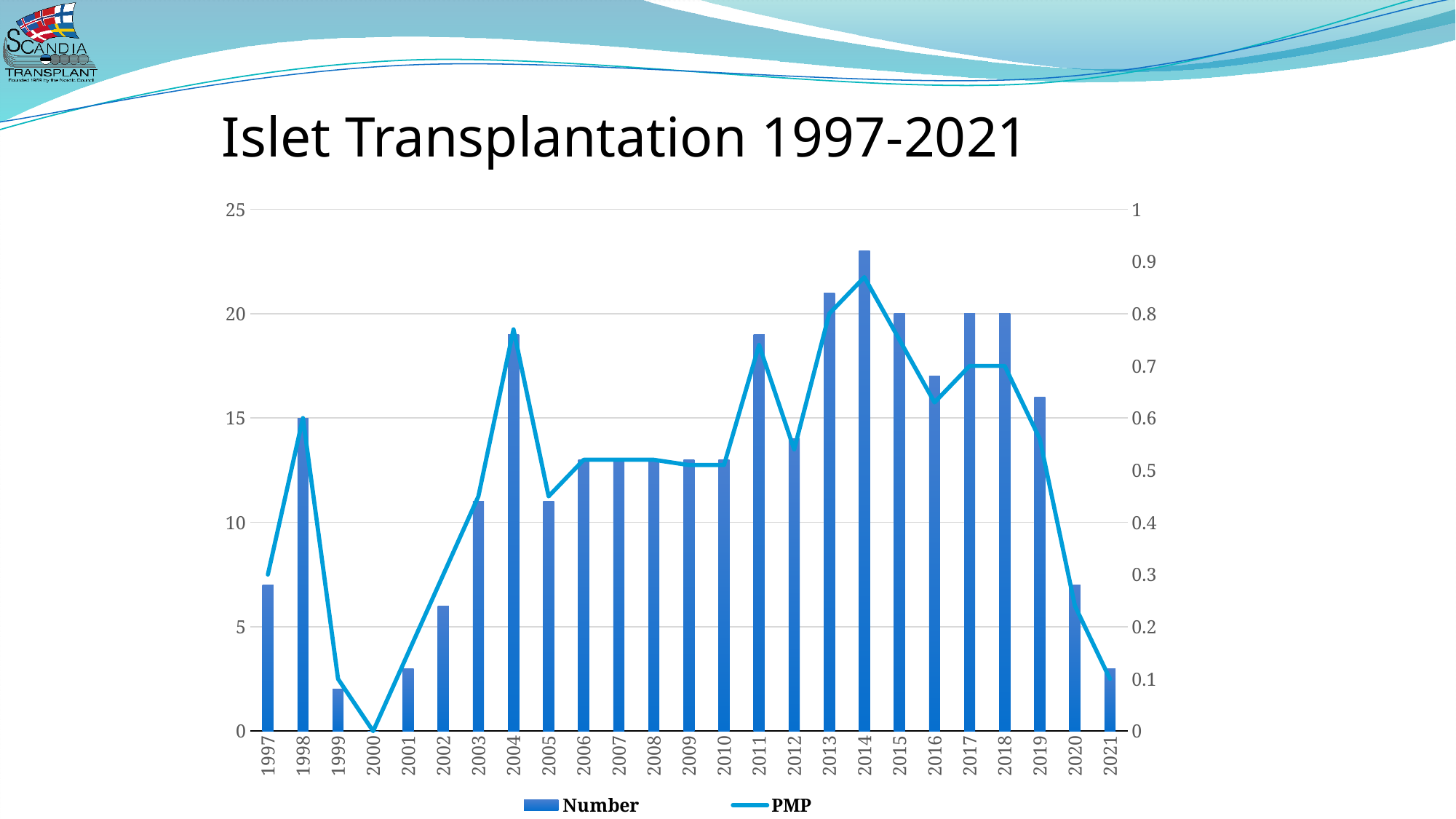
Do the Number values rise or fall from 2018 to 2021? fall What kind of chart is this? Combination bar and line chart Is the Number value for 2014 greater or less than 20? greater How many series does the legend list? 2 What is the Number value for 2015? 20 Which year has a larger Number value, 2004 or 2005? 2004 Which year has the highest Number bar? 2014 What is the title of the chart? Islet Transplantation 1997-2021 Is the Number value for 1999 greater or less than 5? less Which year has the lowest Number bar? 2000 How many years are shown on the x axis? 25 What is the Number value for 1998? 15